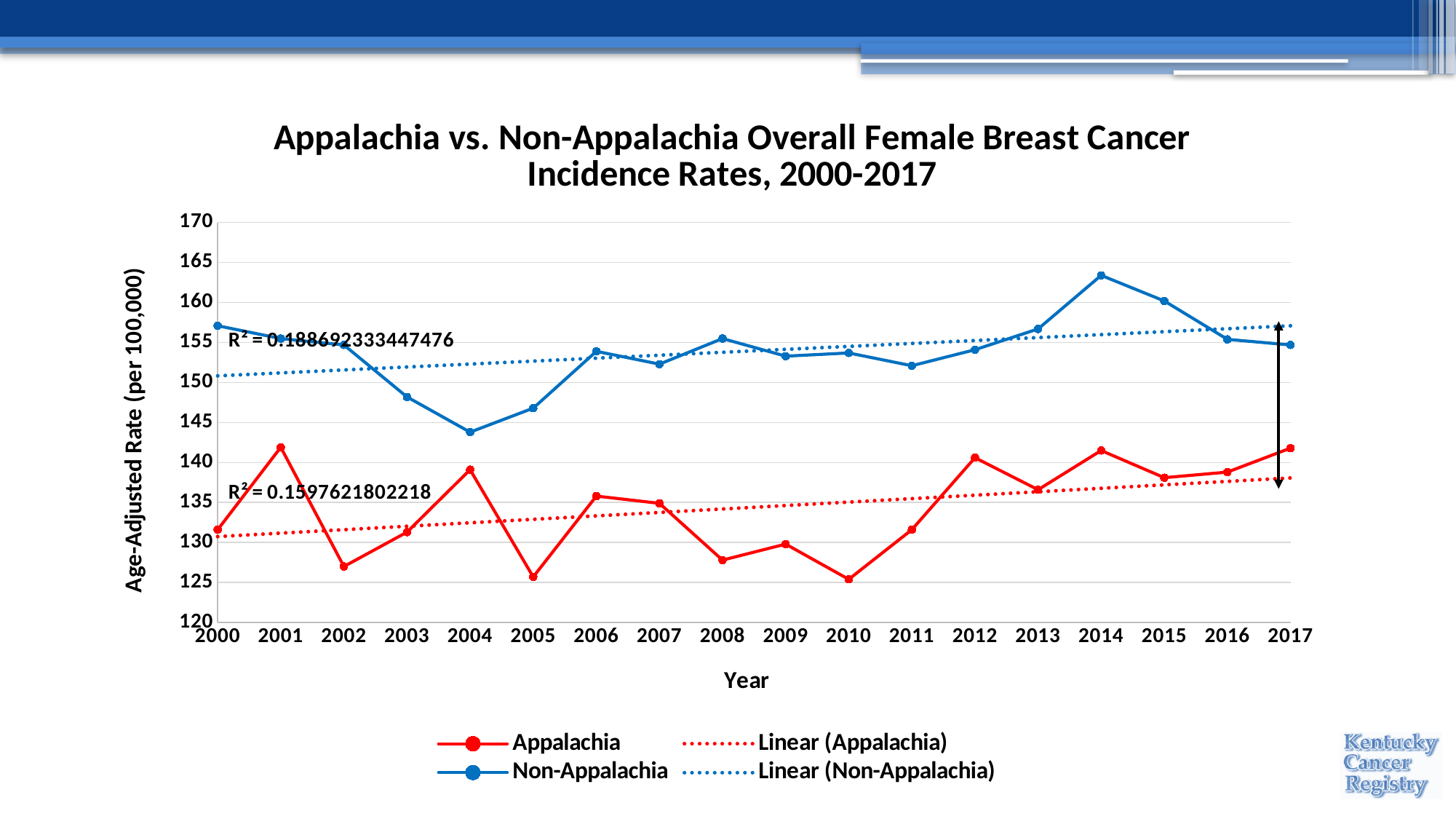
In which year is the Non-Appalachia rate lowest? 2004 Is the Appalachia value for 2010 greater or less than 130? less Is the Non-Appalachia value for 2014 greater or less than 160? greater How many series does the legend list? 4 In which year is the Non-Appalachia rate highest? 2014 Which series has the higher value in 2017, Appalachia or Non-Appalachia? Non-Appalachia Does the Linear (Appalachia) trendline rise or fall from 2000 to 2017? Rise Is the Appalachia value for 2001 greater or less than 140? greater How many years are plotted along the x axis? 18 What kind of chart is shown on the slide? Line chart What R² value is shown for the Non-Appalachia trendline? 0.188692333447476